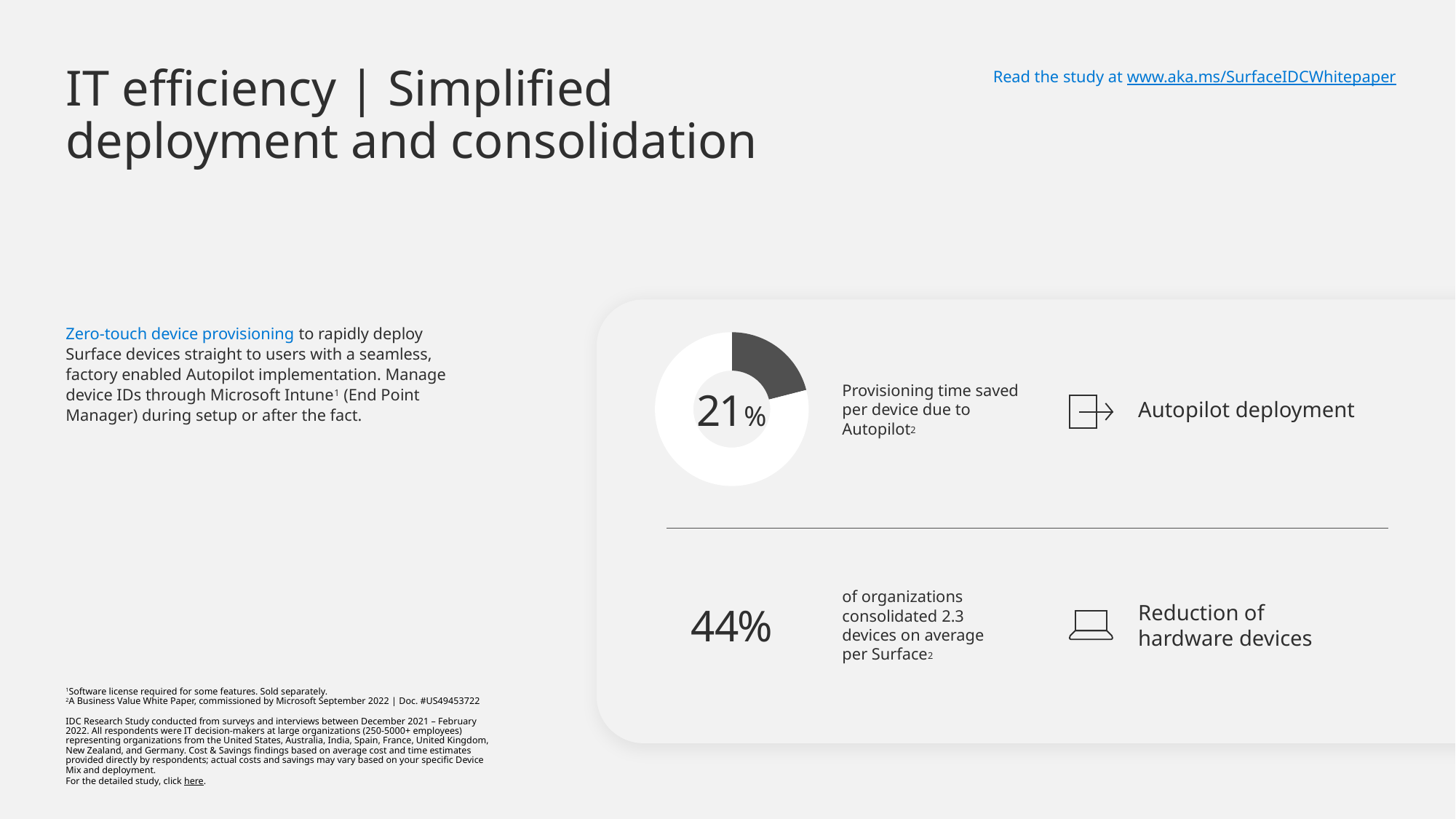
What kind of chart is shown next to the text 'Provisioning time saved per device due to Autopilot'? Donut (pie) chart In the donut chart, which is larger: the dark filled segment or the white remaining portion? The white remaining portion What percentage does the donut chart on the slide display? 21% What share of the donut chart is taken up by the dark filled segment? 21% Is the filled segment of the donut chart greater or less than half of the ring? less What does the 21% in the donut chart represent? Provisioning time saved per device due to Autopilot What colour is the filled segment of the donut chart? Dark grey